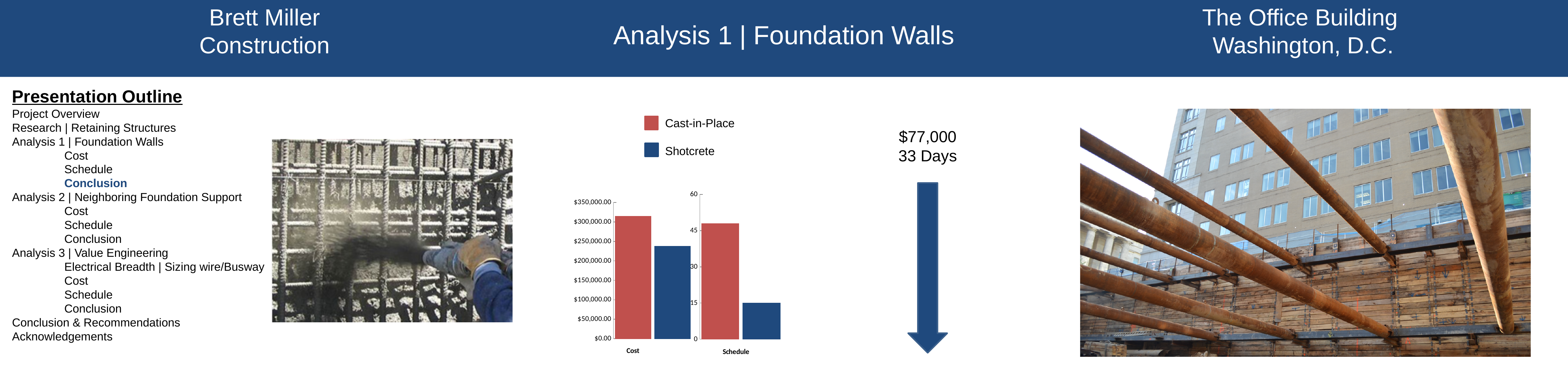
How many categories are shown on the x axis of the chart? 2 Which series is shown in blue in the chart's legend? Shotcrete Is the Cost value for Shotcrete greater or less than $250,000.00? less Which category has the lowest bar in the chart? Schedule What kind of chart is shown on the slide? bar chart Is the Schedule value for Cast-in-Place greater or less than 30? greater Which series is shown in red in the chart's legend? Cast-in-Place Is the Schedule value for Shotcrete greater or less than 30? less In the Schedule category, which series has the larger value, Cast-in-Place or Shotcrete? Cast-in-Place In the Cost category, which series has the larger value, Cast-in-Place or Shotcrete? Cast-in-Place How many series does the chart's legend list? 2